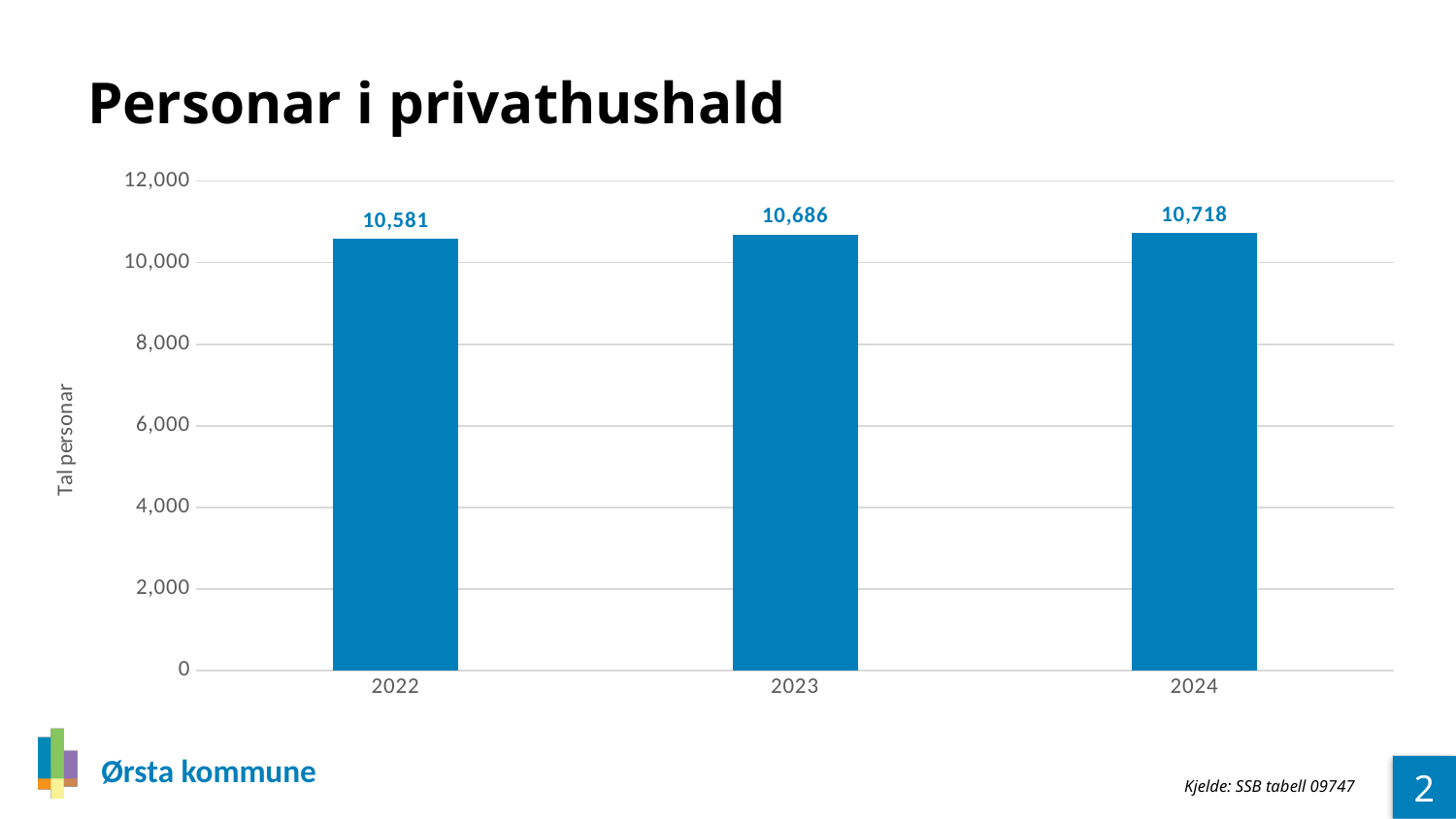
What is the value for 2023? 10,686 What is the value for 2022? 10,581 What is the value for 2024? 10,718 Is the value for 2023 greater or less than 10,000? greater What is the title of the chart? Personar i privathushald Which year has the lowest value? 2022 What kind of chart is shown on the slide? bar chart Which year has the highest value? 2024 What is the difference between the values for 2024 and 2022? 137 How many years are shown on the x axis? 3 What is the difference between the values for 2023 and 2022? 105 Do the values rise or fall from 2022 to 2024? rise